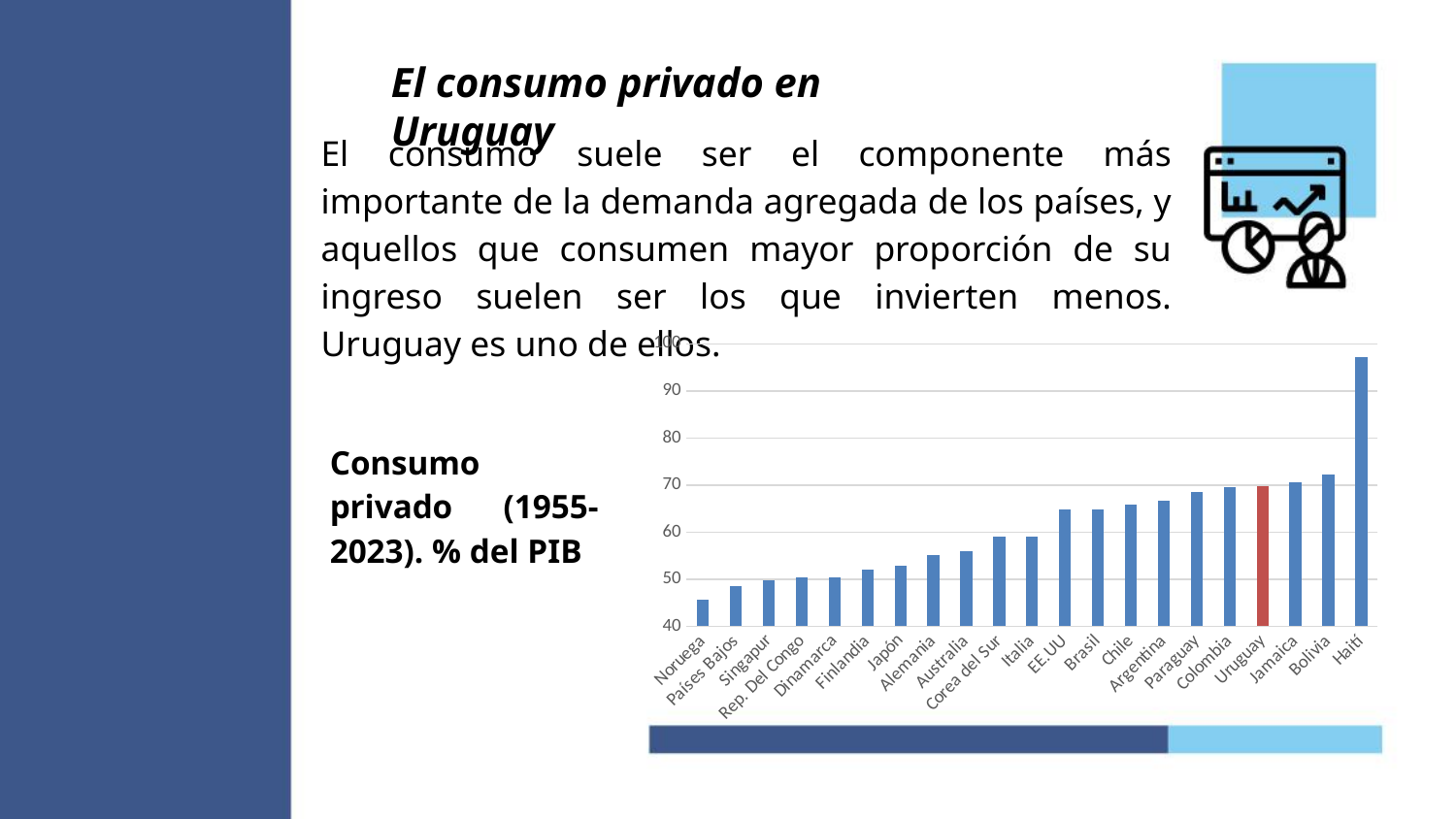
Which country's bar is highlighted in a different colour (red) from the others? Uruguay Do the values rise or fall moving from left to right along the x axis? rise Is the value for Bolivia greater or less than 70? greater What kind of chart is shown on the slide? bar chart Which country has the highest value in the chart? Haití Is the value for Haití greater or less than 90? greater Is the value for EE.UU greater or less than 60? greater Which country has the lowest value in the chart? Noruega How many countries are shown on the x axis of the chart? 21 Which has a larger value, Bolivia or Finlandia? Bolivia